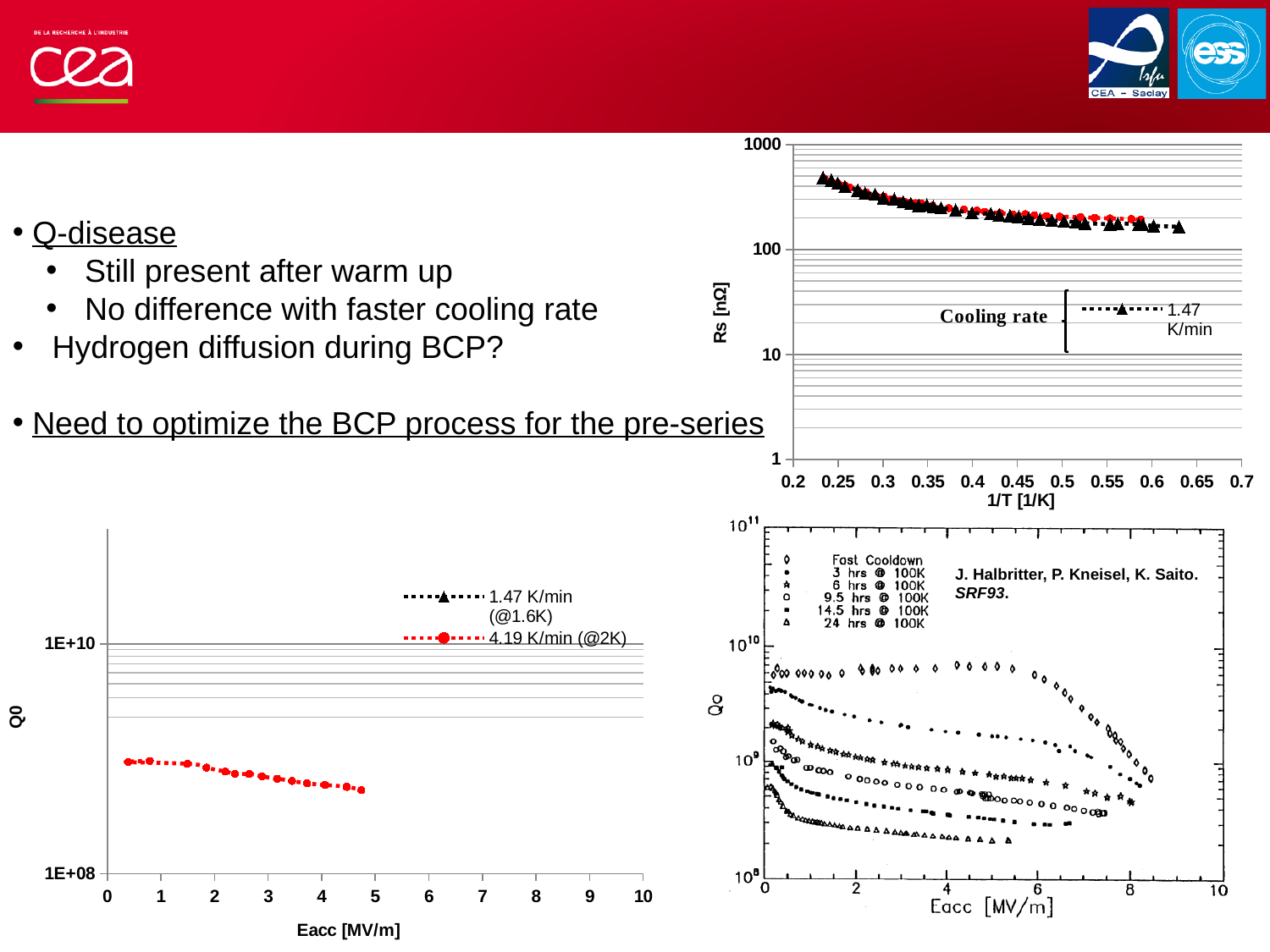
In the bottom-right chart (Qo vs Eacc, Halbritter et al.), which series has the lowest Qo values? 24 hrs @ 100K In the bottom-right chart (Qo vs Eacc, Halbritter et al.), which series has the highest Qo values? Fast Cooldown In the top-right chart (Rs vs 1/T), is the Rs value at 1/T = 0.25 greater or less than 1000? less In the top-right chart (Rs vs 1/T), what is the label of the y axis? Rs [nΩ] In the bottom-left chart (Q0 vs Eacc), what is the label of the x axis? Eacc [MV/m] In the bottom-left chart (Q0 vs Eacc), how many series does the legend list? 2 In the bottom-left chart (Q0 vs Eacc), do the plotted Q0 values rise or fall as Eacc increases? fall In the bottom-left chart (Q0 vs Eacc), is the Q0 value of the 4.19 K/min (@2K) series at Eacc = 1 MV/m greater or less than 1E+10? less In the top-right chart (Rs vs 1/T), what cooling rate is listed in the legend? 1.47 K/min In the top-right chart (Rs vs 1/T), do the Rs values rise or fall as 1/T increases? fall In the top-right chart (Rs vs 1/T), is the Rs value at 1/T = 0.6 greater or less than 100? greater In the bottom-right chart (Qo vs Eacc, Halbritter et al.), how many series does the legend list? 6